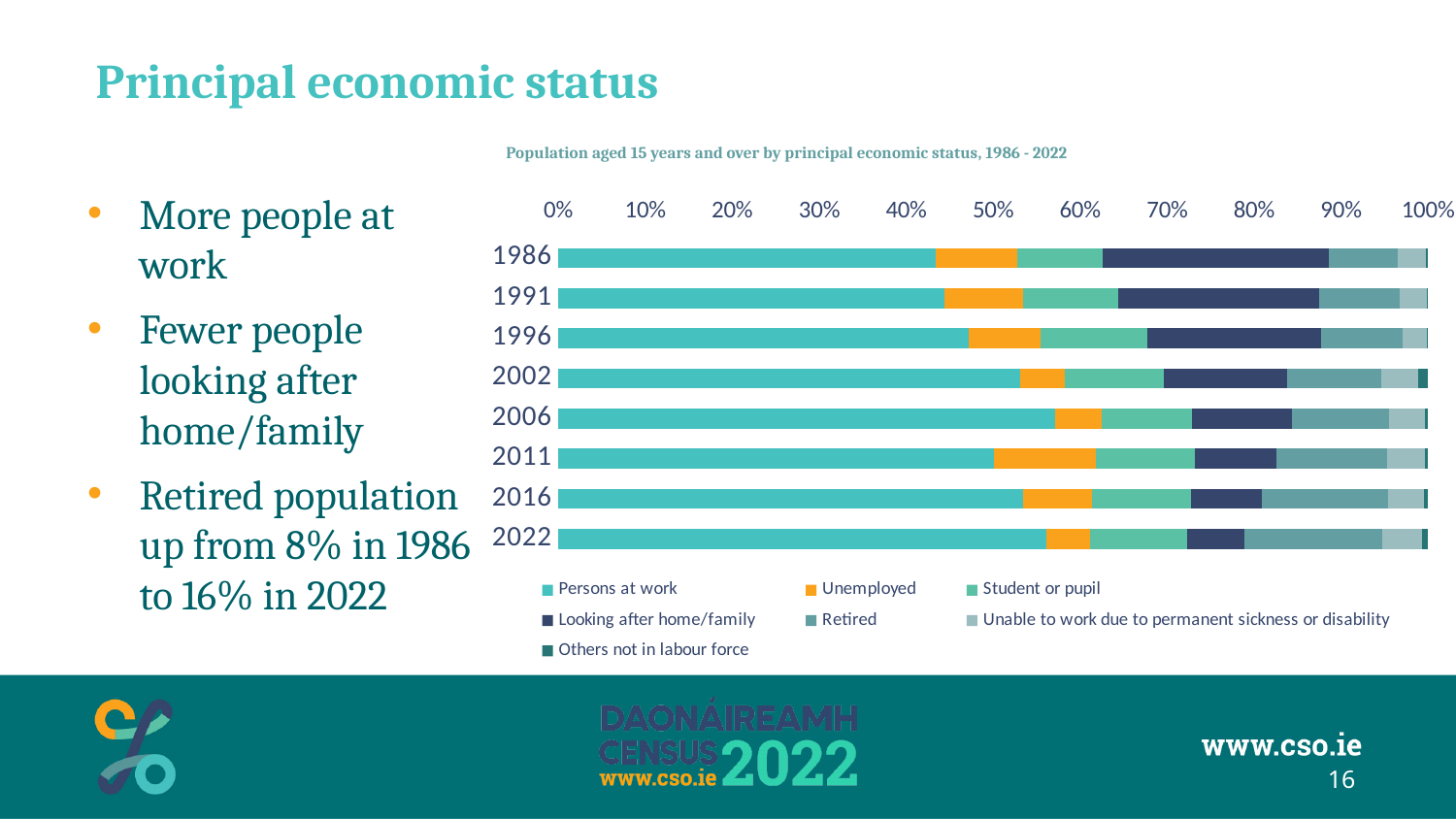
Which year has the largest Unemployed segment? 2011 Which is larger, the Persons at work share in 1986 or in 2022? 2022 What is the title of the chart? Population aged 15 years and over by principal economic status, 1986 - 2022 What kind of chart is shown on the slide? Stacked bar chart Which colour represents Unemployed in the chart? Orange Is the value for Persons at work in 1986 greater or less than 50%? less How many years (categories) are shown on the chart? 8 Is the value for Persons at work in 2022 greater or less than 50%? greater How many series does the chart legend list? 7 According to the slide, what share of the population was retired in 2022? 16% Is the value for Persons at work in 2006 greater or less than 50%? greater Does the Persons at work share generally rise or fall from 1986 to 2022? Rise